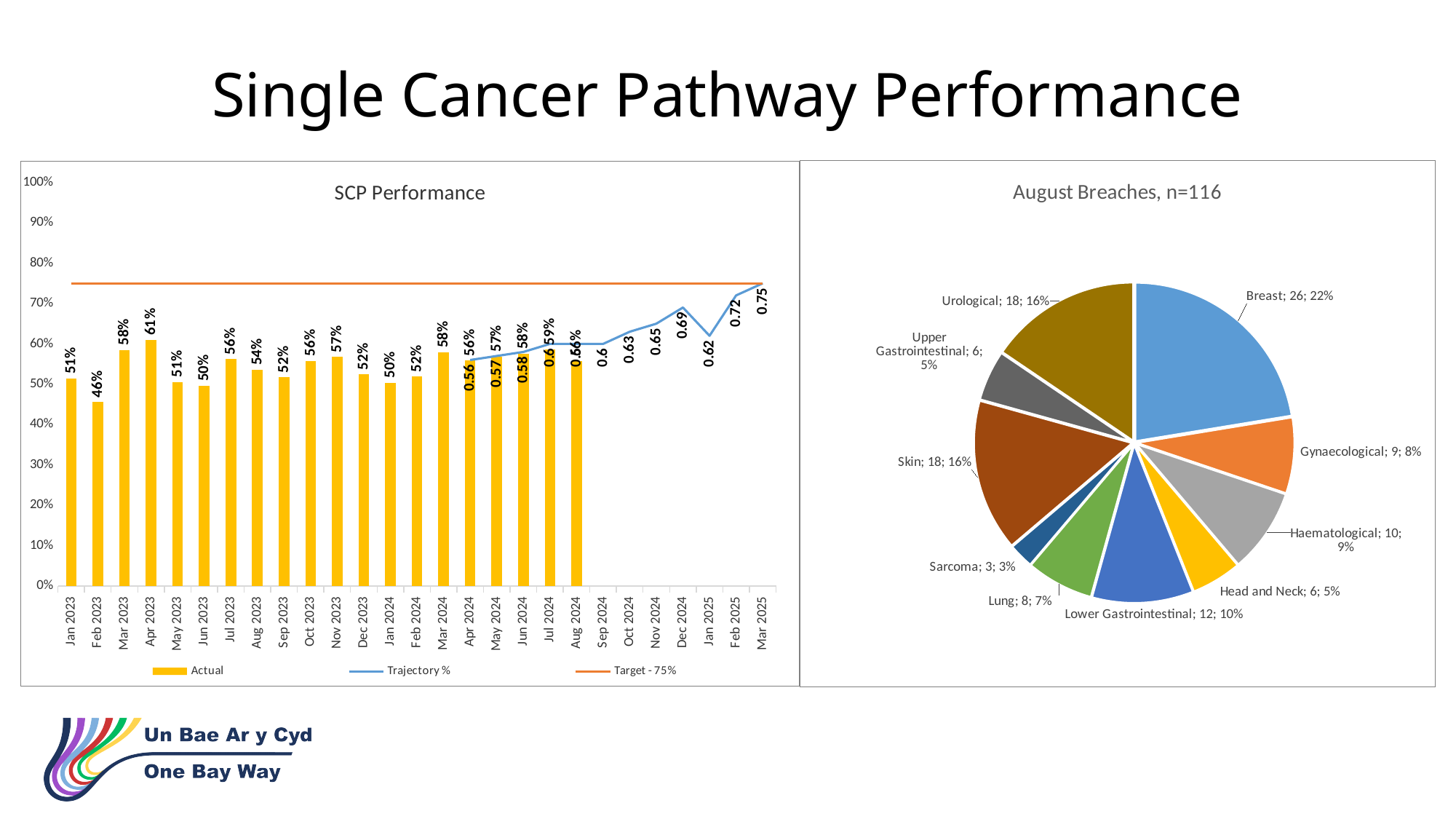
In the SCP Performance chart, which month has the highest Actual value? Apr 2023 In the August Breaches pie chart, how many breaches are attributed to Skin? 18 In the SCP Performance chart, what is the difference between the Actual values for Apr 2023 and Feb 2023? 15 percentage points In the SCP Performance chart, is the Actual value for Jul 2024 larger or smaller than the Actual value for Jan 2024? larger In the SCP Performance chart, what is the Trajectory % value for Mar 2025? 0.75 In the August Breaches pie chart, which category has the smallest slice? Sarcoma How many categories are shown in the August Breaches pie chart? 10 In the August Breaches pie chart, which category has the largest slice? Breast How many series does the legend of the SCP Performance chart list? 3 In the SCP Performance chart, which month has the lowest Actual value? Feb 2023 In the SCP Performance chart, what is the Actual value for Apr 2023? 61% In the August Breaches pie chart, what share of breaches is Lower Gastrointestinal? 10%